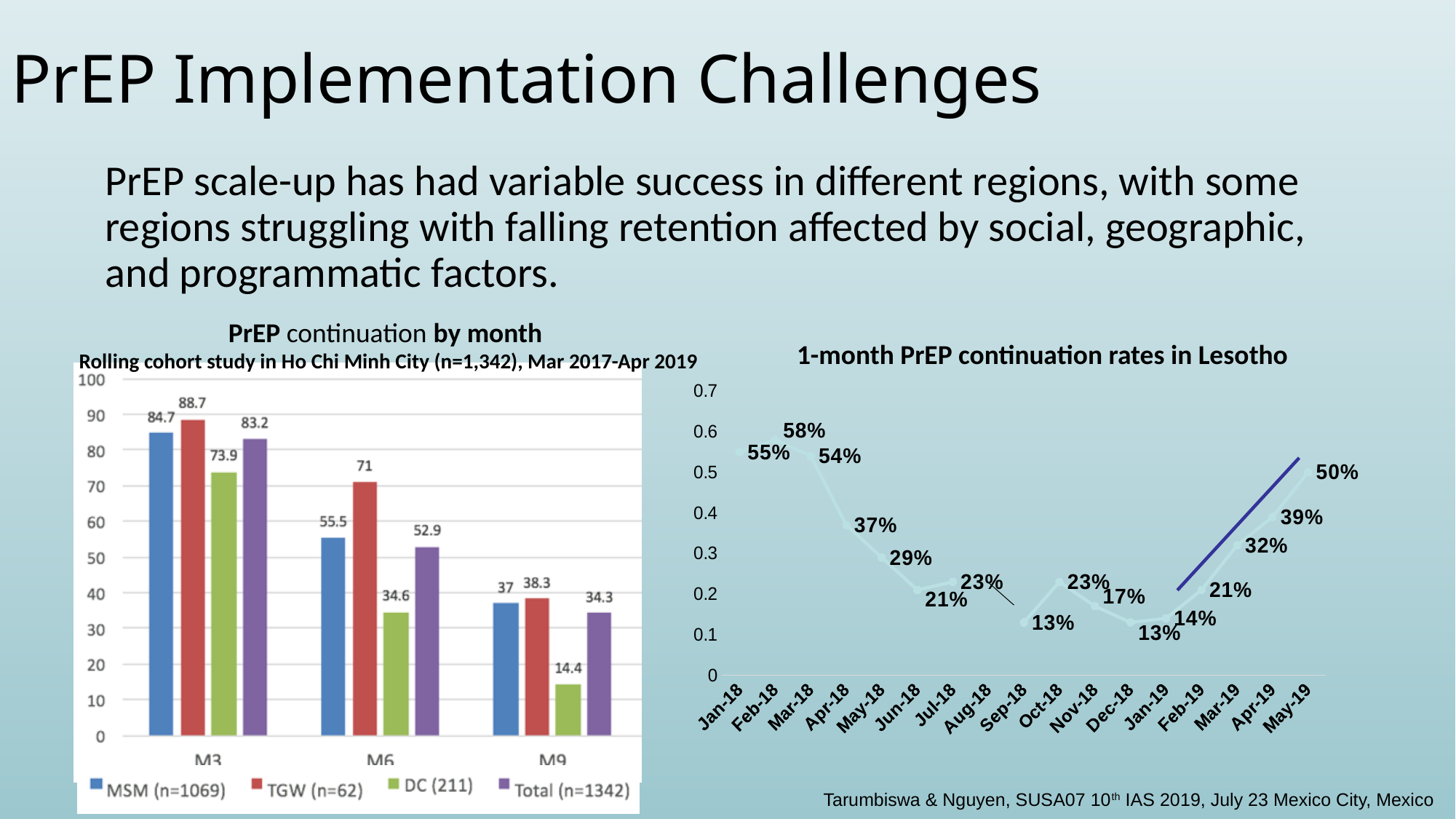
In the 'PrEP continuation by month' bar chart, what is the difference between the TGW and MSM values at M6? 15.5 In the '1-month PrEP continuation rates in Lesotho' chart, which month has the highest continuation rate? Feb-18 In the 'PrEP continuation by month' bar chart, which series has the lowest value at M9? DC (211) How many series does the legend of the 'PrEP continuation by month' bar chart list? 4 In the '1-month PrEP continuation rates in Lesotho' chart, which is larger, the value for Mar-19 or the value for Oct-18? Mar-19 How many month categories are shown on the x axis of the 'PrEP continuation by month' bar chart? 3 What kind of chart is '1-month PrEP continuation rates in Lesotho'? line chart In the 'PrEP continuation by month' bar chart, do the MSM values rise or fall from M3 to M9? fall In the '1-month PrEP continuation rates in Lesotho' chart, what is the value for Feb-18? 58% In the 'PrEP continuation by month' bar chart, what is the value for TGW at M3? 88.7 In the 'PrEP continuation by month' bar chart, which series has the highest value at M3? TGW (n=62) In the 'PrEP continuation by month' bar chart, what is the Total value at M6? 52.9